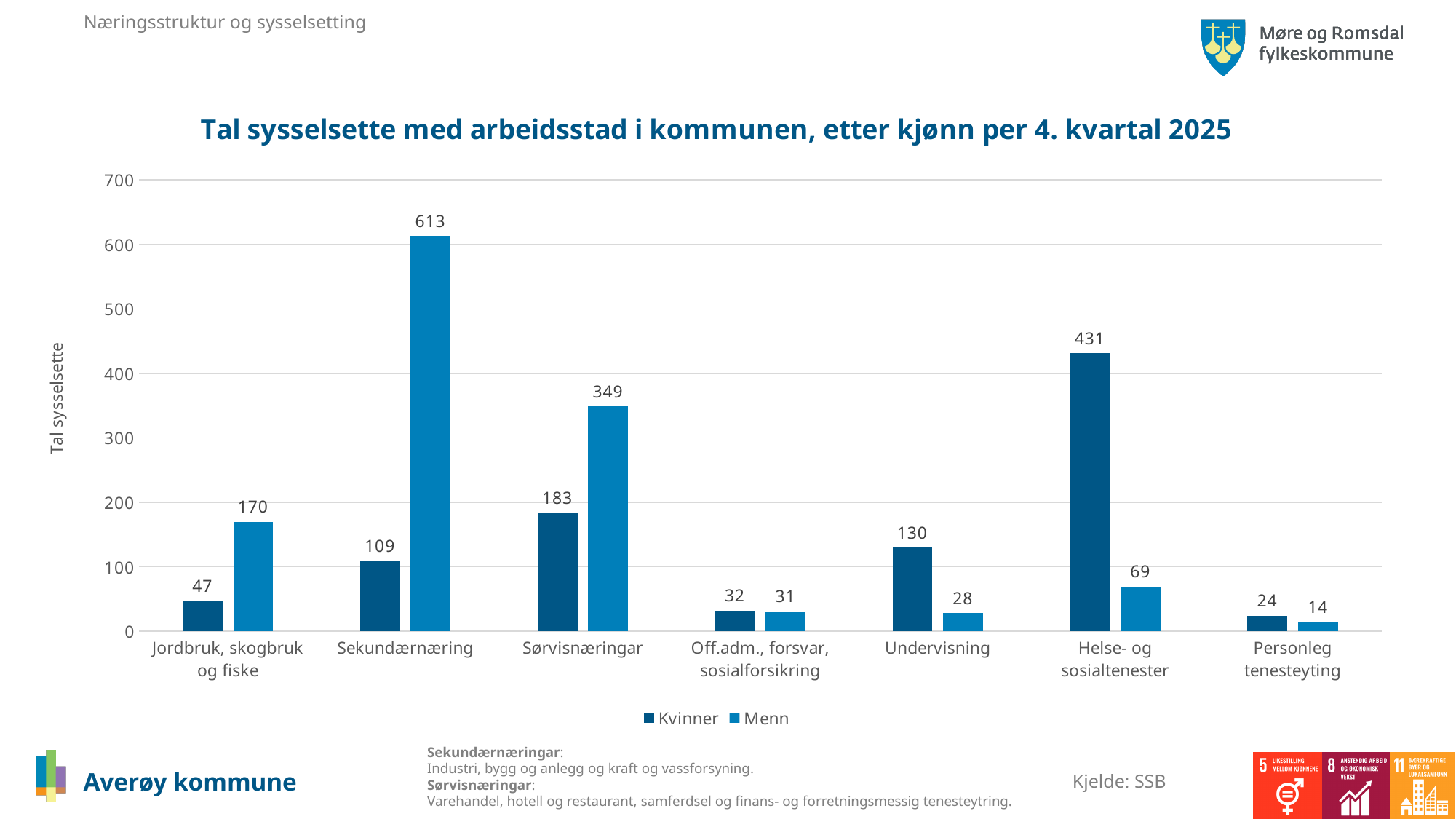
What is the difference between Menn and Kvinner in Sørvisnæringar? 166 Which category has the lowest value for Kvinner? Personleg tenesteyting What is the value for Menn in Sekundærnæring? 613 Is the value for Menn in Jordbruk, skogbruk og fiske greater or less than 100? greater How many series does the legend list? 2 What kind of chart is shown? bar chart Which category has the highest value for Menn? Sekundærnæring What is the label of the y axis? Tal sysselsette What is the value for Kvinner in Undervisning? 130 Which is larger in Helse- og sosialtenester, Kvinner or Menn? Kvinner What is the value for Kvinner in Helse- og sosialtenester? 431 How many categories are shown on the x axis? 7